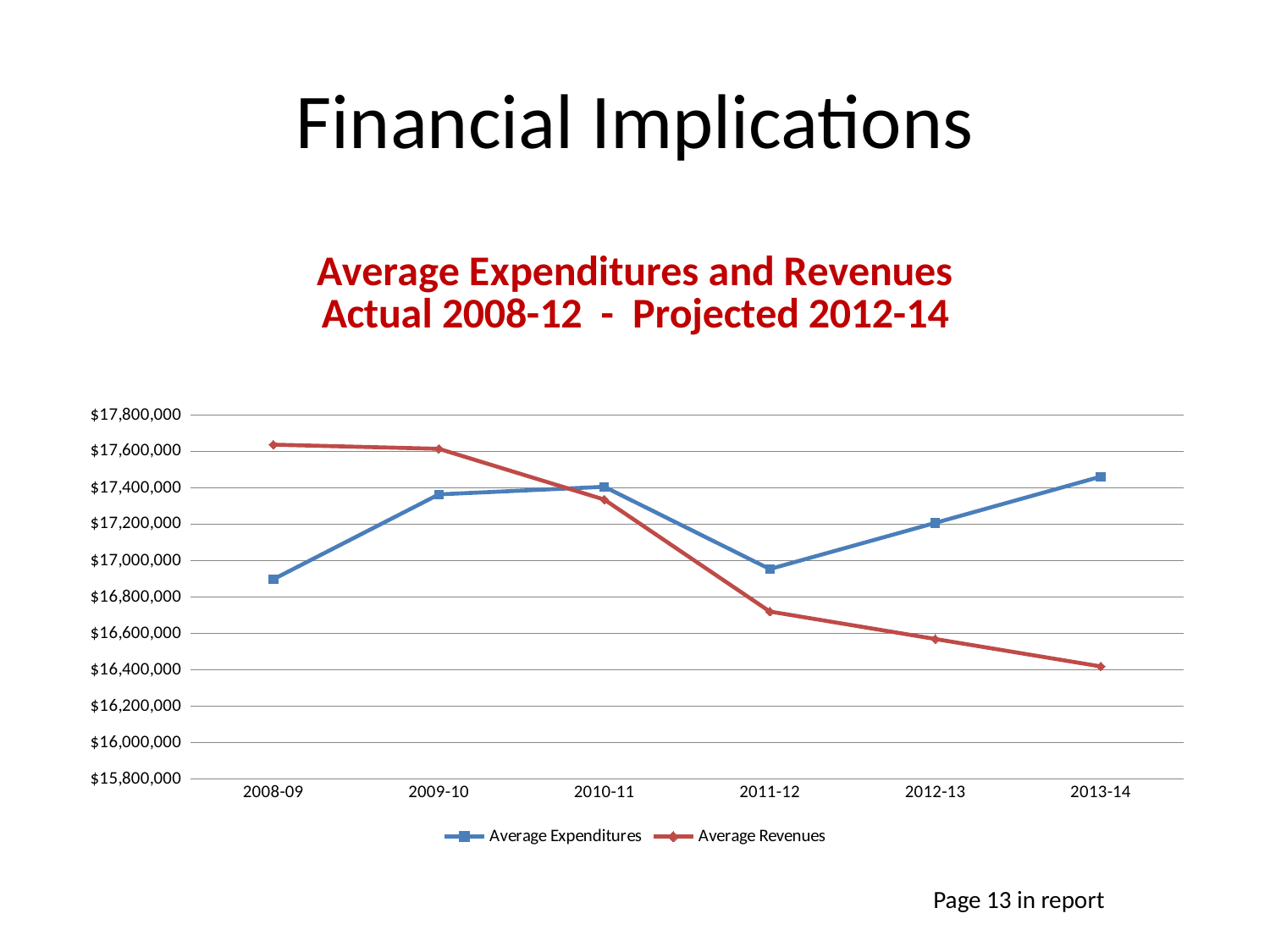
In 2013-14, which is larger: Average Expenditures or Average Revenues? Average Expenditures Is the Average Revenues value for 2013-14 greater or less than $16,600,000? less Which series is drawn in red? Average Revenues Which year has the lowest Average Revenues value? 2013-14 Is the Average Revenues value for 2008-09 greater or less than $17,400,000? greater How many series does the legend list? 2 Is the Average Expenditures value for 2013-14 greater or less than $17,200,000? greater What kind of chart is shown on the slide? Line chart Do the Average Revenues values rise or fall from 2008-09 to 2013-14? Fall In 2008-09, which is larger: Average Expenditures or Average Revenues? Average Revenues How many fiscal years are plotted along the x axis? 6